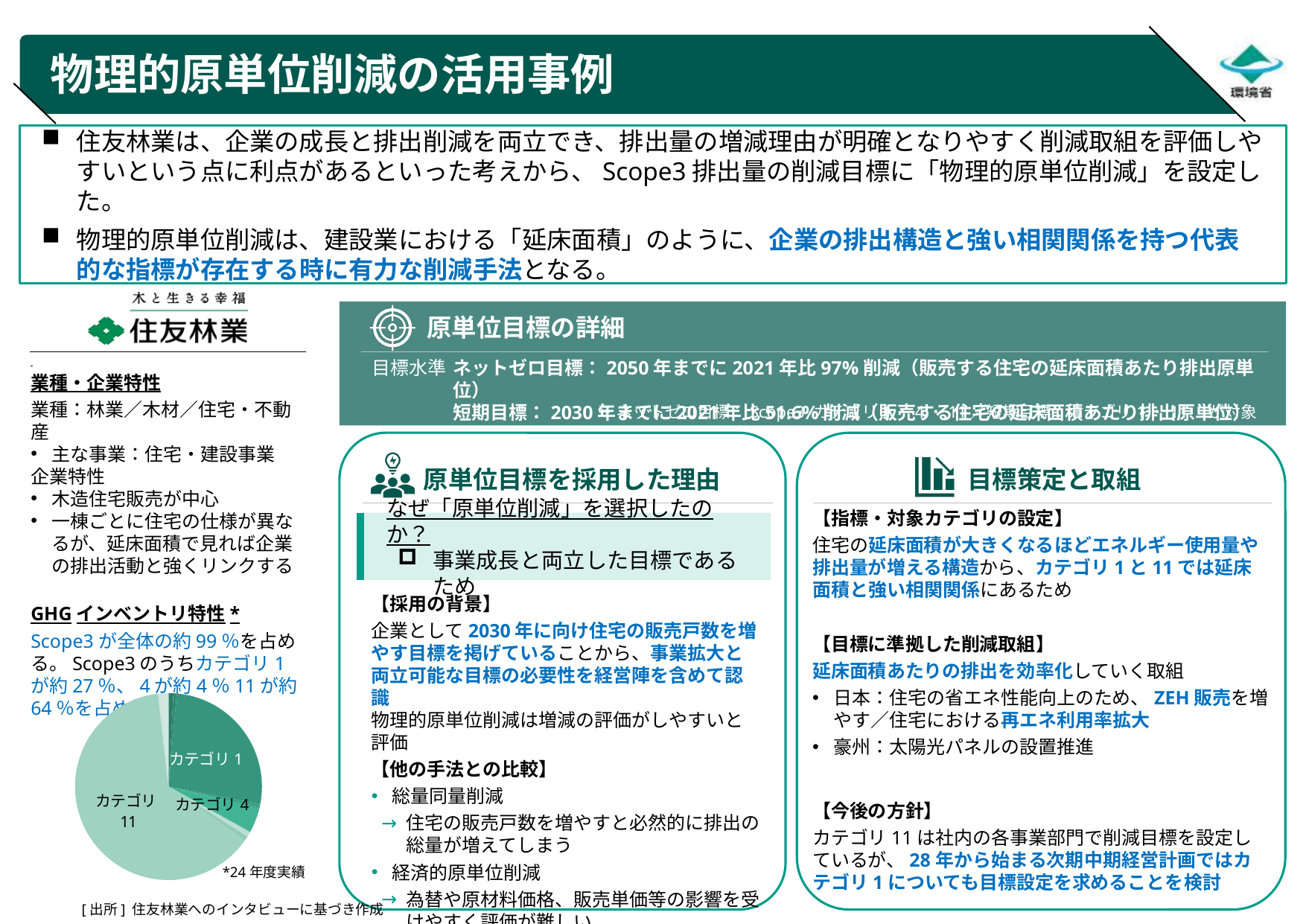
In the pie chart, which slice is larger: カテゴリ 4 or カテゴリ 11? カテゴリ 11 In the pie chart, which slice is larger: カテゴリ 1 or カテゴリ 11? カテゴリ 11 What footnote is printed below the pie chart indicating the fiscal year of the data? *24 年度実績 Which category has the largest slice in the pie chart? カテゴリ 11 In the pie chart, which slice is larger: カテゴリ 1 or カテゴリ 4? カテゴリ 1 What are the labels of the three slices in the pie chart? カテゴリ 1, カテゴリ 4, カテゴリ 11 What kind of chart is shown on the slide? pie chart